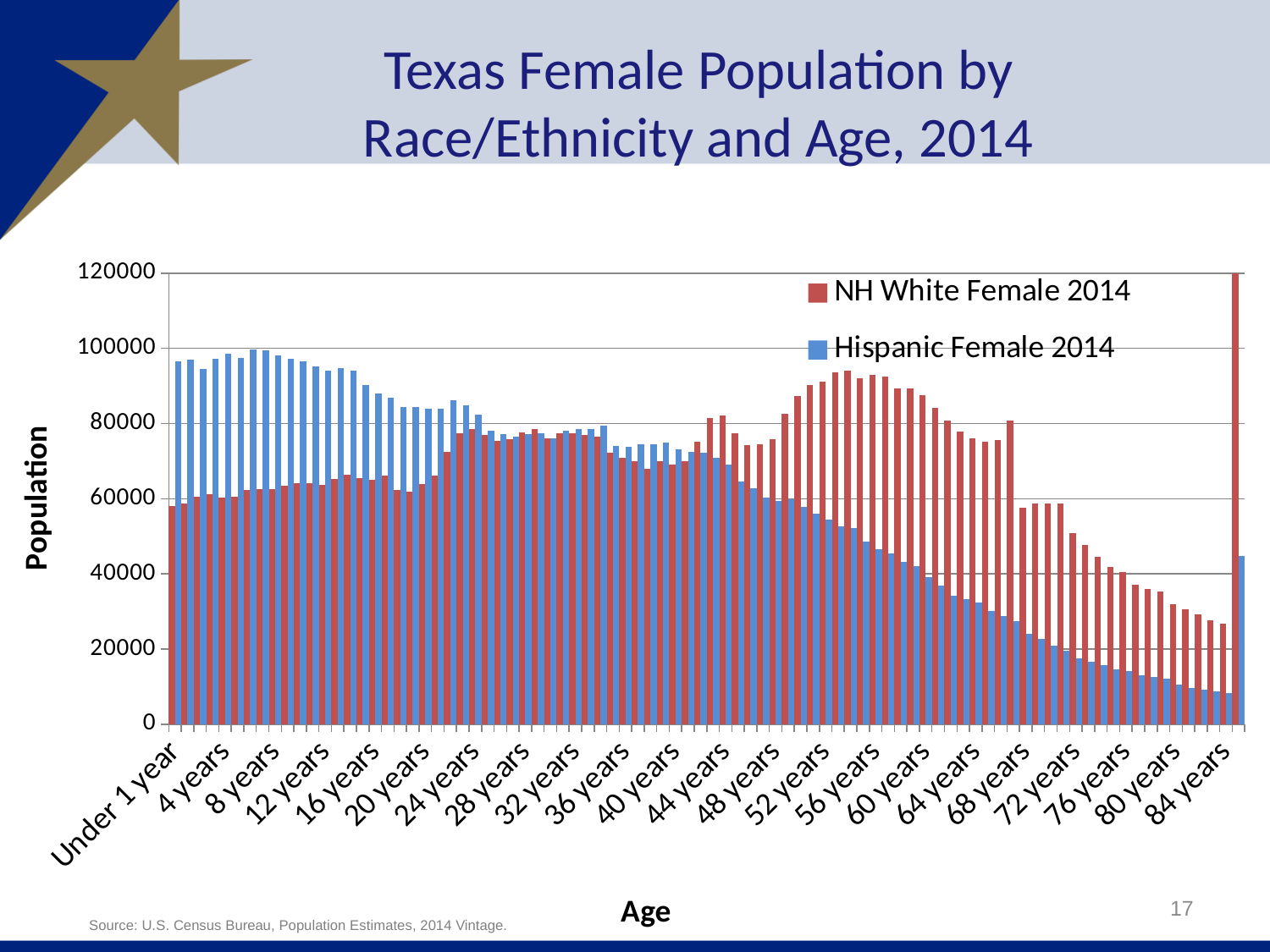
What is the label on the vertical axis of the chart? Population At 72 years, which series has the larger value, NH White Female 2014 or Hispanic Female 2014? NH White Female 2014 Is the value for NH White Female 2014 at 4 years greater or less than 80000? less Is the value for Hispanic Female 2014 at 84 years greater or less than 20000? less Is the value for Hispanic Female 2014 at 64 years greater or less than 40000? less At 4 years, which series has the larger value, NH White Female 2014 or Hispanic Female 2014? Hispanic Female 2014 Do the Hispanic Female 2014 values generally rise or fall from 8 years to 84 years? fall What kind of chart is shown on the slide? Bar chart How many series does the legend list? 2 What is the title of the chart? Texas Female Population by Race/Ethnicity and Age, 2014